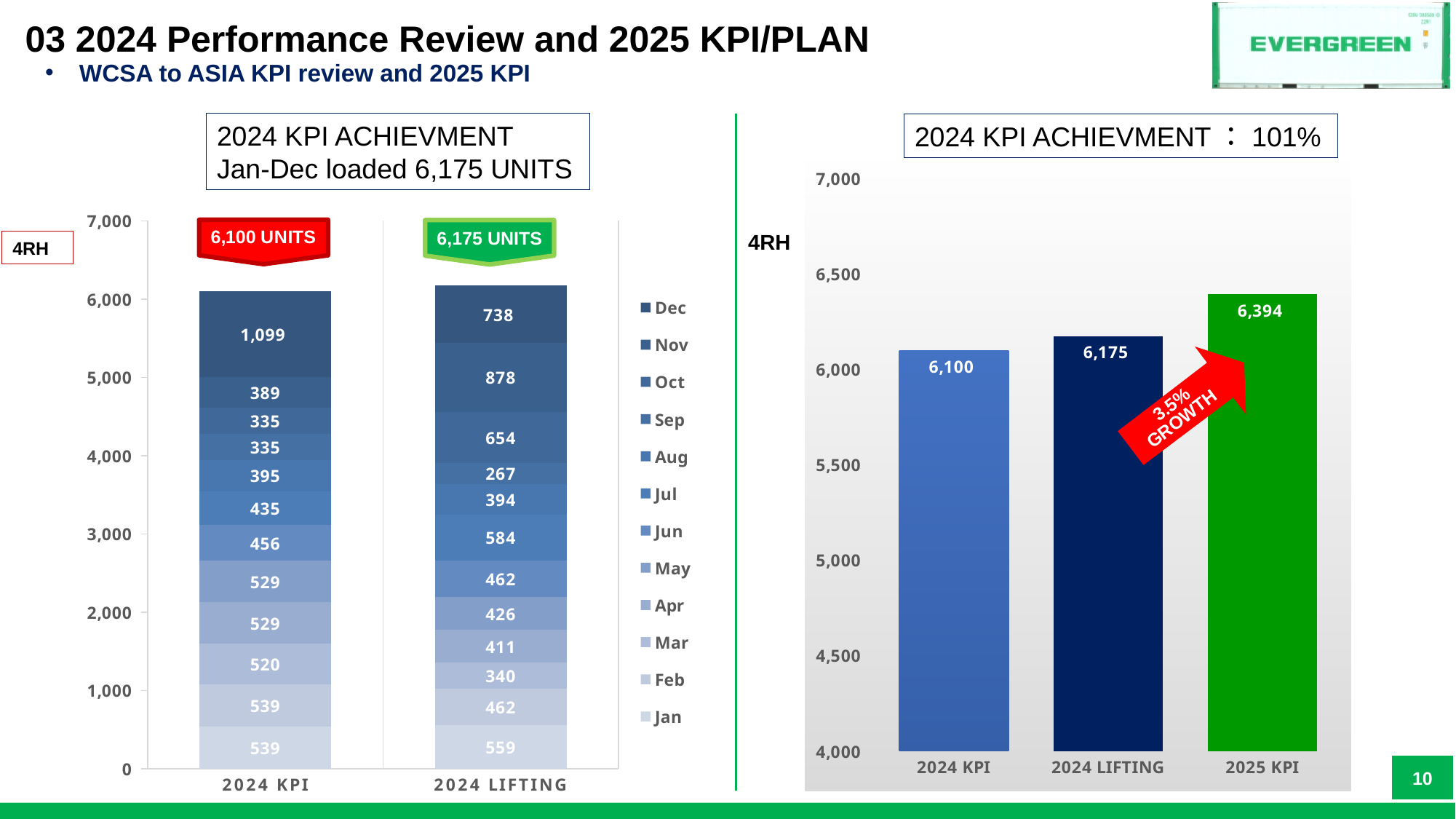
In the left stacked bar chart, how many series does the legend list? 12 In the left stacked bar chart, what is the total for the 2024 LIFTING bar? 6,175 UNITS In the left stacked bar chart, what is the Jan value in the 2024 LIFTING bar? 559 In the right bar chart, what is the difference between 2025 KPI and 2024 LIFTING? 219 In the left stacked bar chart, what is the total for the 2024 KPI bar? 6,100 UNITS In the left stacked bar chart, what is the Nov value in the 2024 LIFTING bar? 878 In the right bar chart, which category has the highest value? 2025 KPI In the right bar chart, how many bars are plotted? 3 In the left stacked bar chart, which month has the largest segment in the 2024 LIFTING bar? Nov In the left stacked bar chart, what is the Dec value in the 2024 KPI bar? 1,099 In the left stacked bar chart, which month has the smallest segment in the 2024 LIFTING bar? Sep In the right bar chart, what is the value for 2025 KPI? 6,394